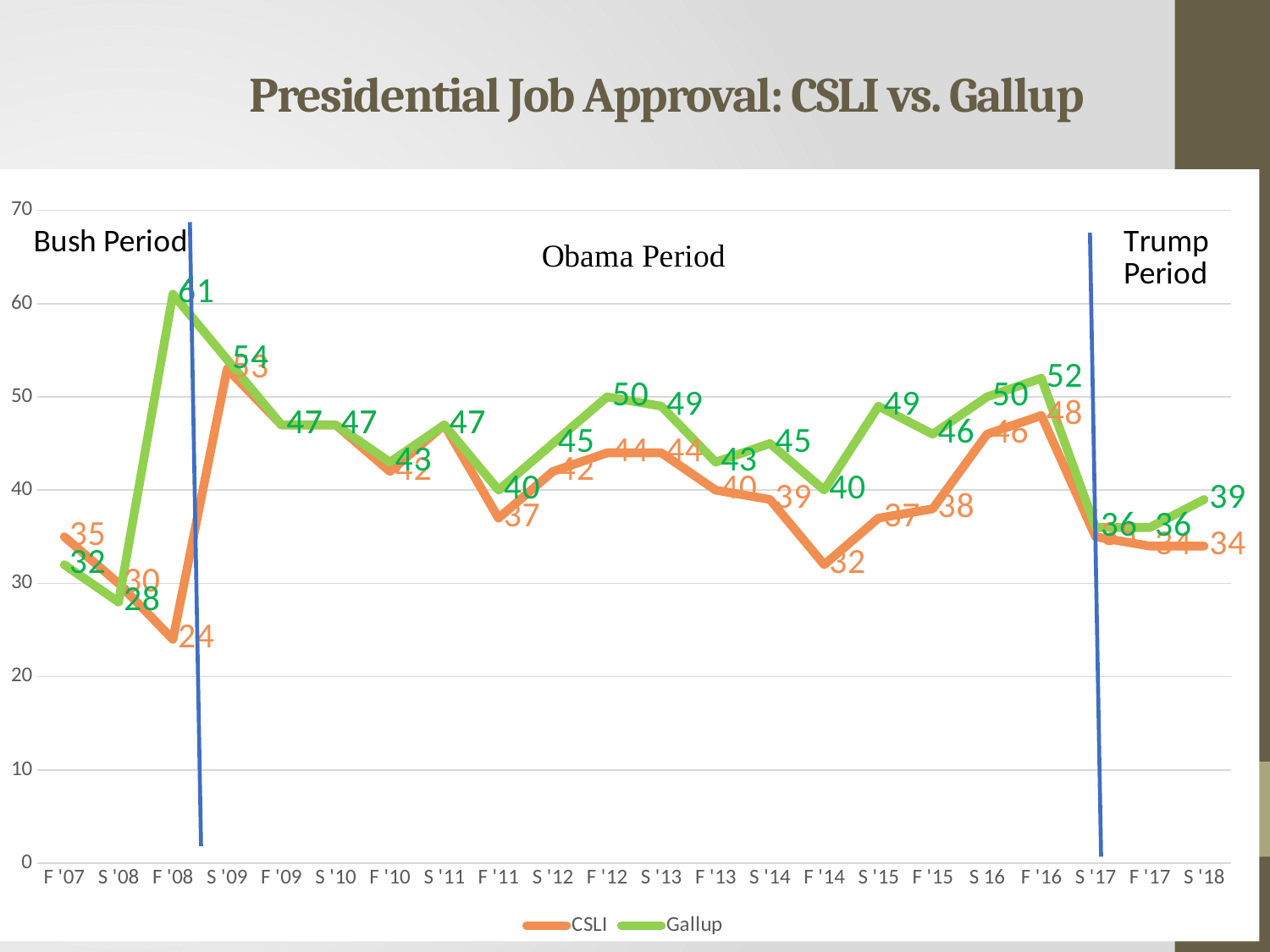
Is the CSLI value for F '14 greater or less than 40? less At which period does the CSLI series reach its lowest value? F '08 At which period does the Gallup series reach its highest value? F '08 What is the difference between the Gallup and CSLI values at F '08? 37 What is the Gallup value for F '08? 61 What is the CSLI value for F '14? 32 What is the Gallup value for S '18? 39 How many series does the legend list? 2 Which series has the larger value at F '16, CSLI or Gallup? Gallup Which series is drawn in orange? CSLI What is the CSLI value for F '08? 24 What kind of chart is shown on the slide? line chart